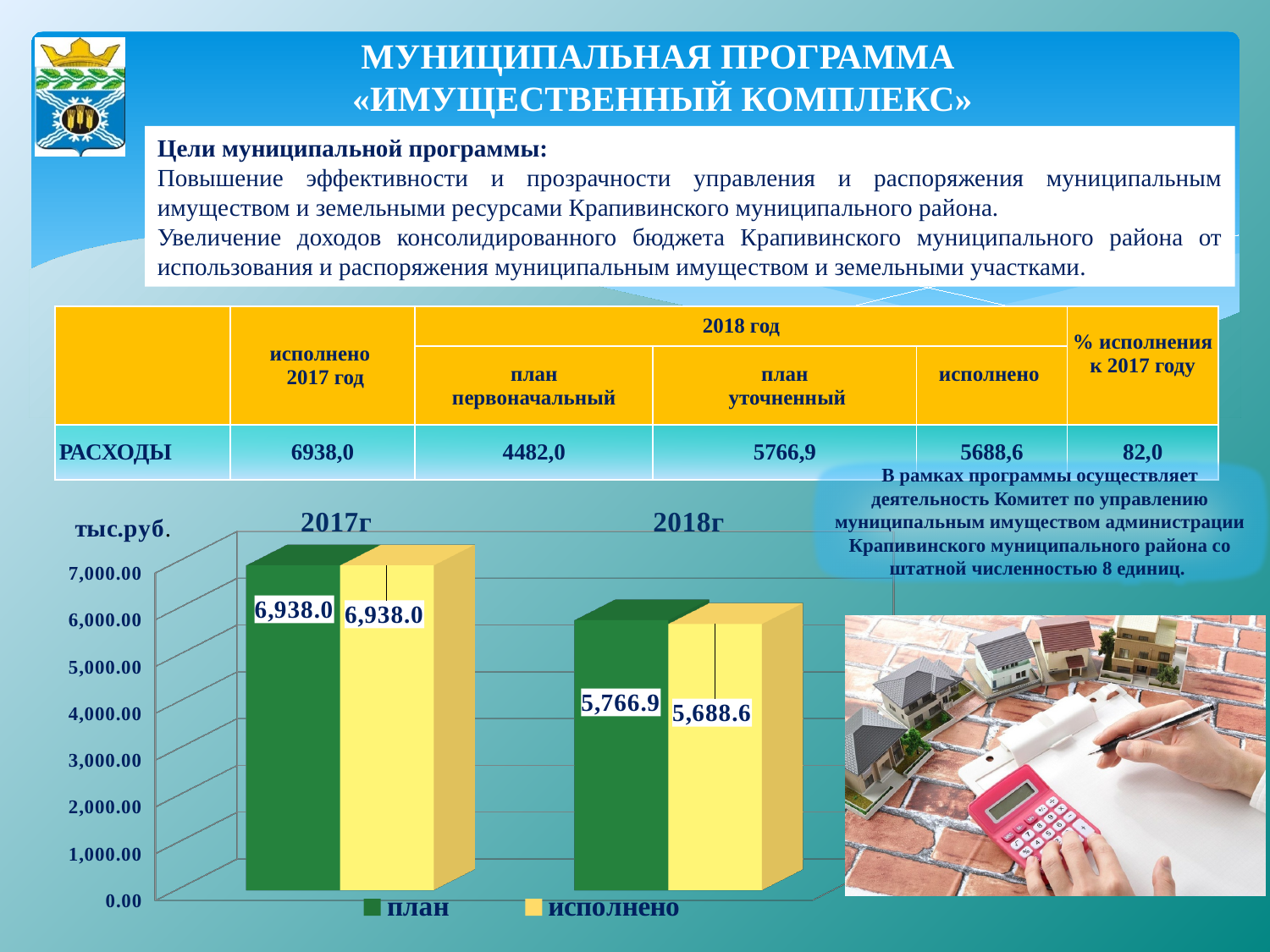
What unit is shown on the chart's vertical axis label? тыс.руб. What is the difference between план and исполнено for 2018г? 78.3 What kind of chart is shown on the slide? bar chart What is the value of исполнено for 2017г? 6,938.0 Is the план value for 2018г greater or less than 6,000.00? less What is the value of план for 2018г? 5,766.9 What is the value of исполнено for 2018г? 5,688.6 What is the difference between the исполнено values for 2017г and 2018г? 1,249.4 How many series does the legend list? 2 Which year has the lower исполнено value? 2018г Which year has the higher план value? 2017г What is the value of план for 2017г? 6,938.0